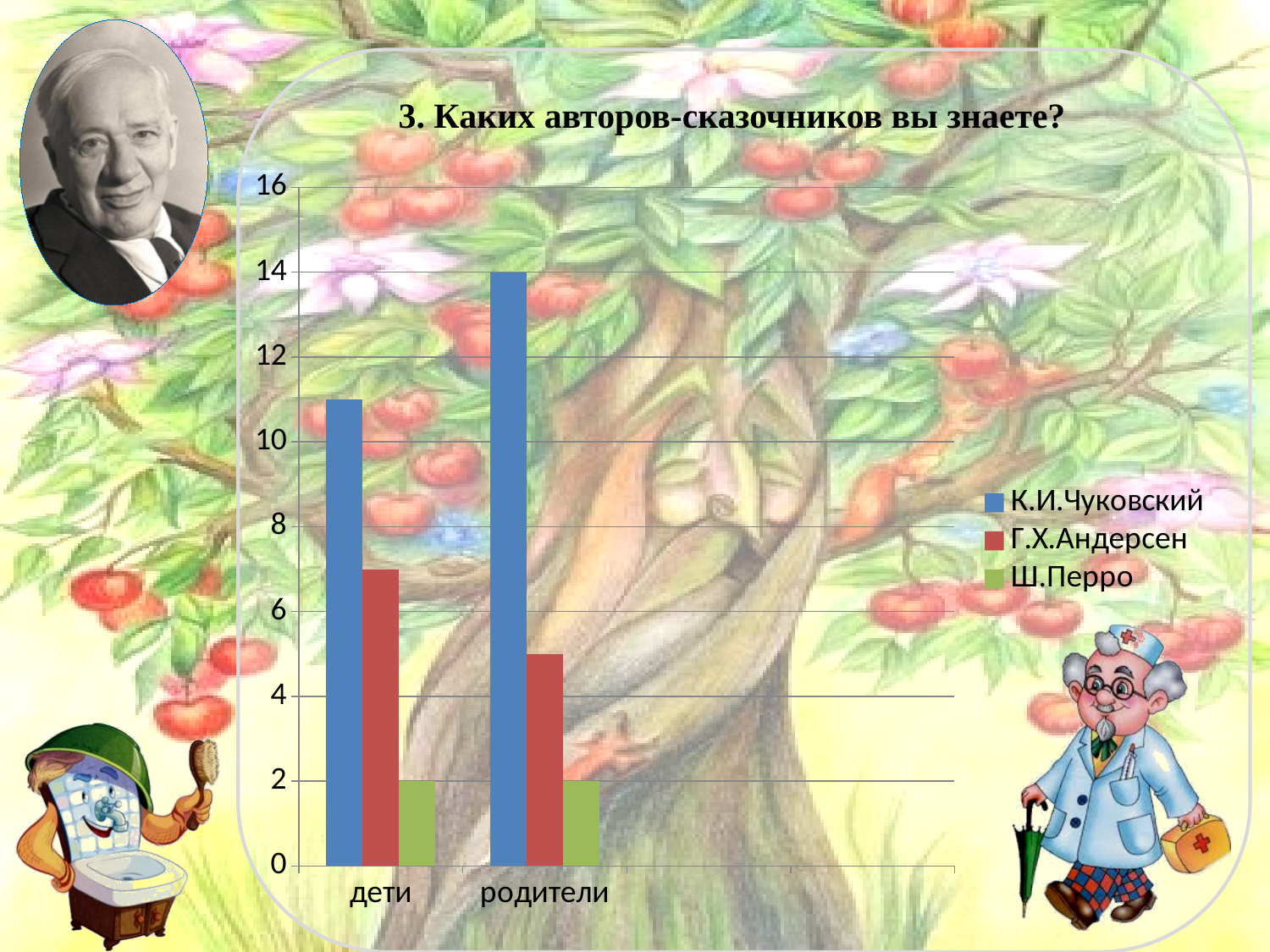
Which author has the highest value in the родители category? К.И.Чуковский Does the value for Г.Х.Андерсен rise or fall from дети to родители? fall Is the value for К.И.Чуковский in the дети category greater or less than 10? greater How many series does the legend list? 3 Which author has the lowest value in the дети category? Ш.Перро What is the value for К.И.Чуковский in the родители category? 14 What is the title of the chart? 3. Каких авторов-сказочников вы знаете? How many categories are shown on the x axis? 2 What is the difference between К.И.Чуковский and Ш.Перро in the родители category? 12 What kind of chart is shown on the slide? bar chart What is the value for Ш.Перро in the дети category? 2 Is the value for Г.Х.Андерсен in the родители category greater or less than 6? less